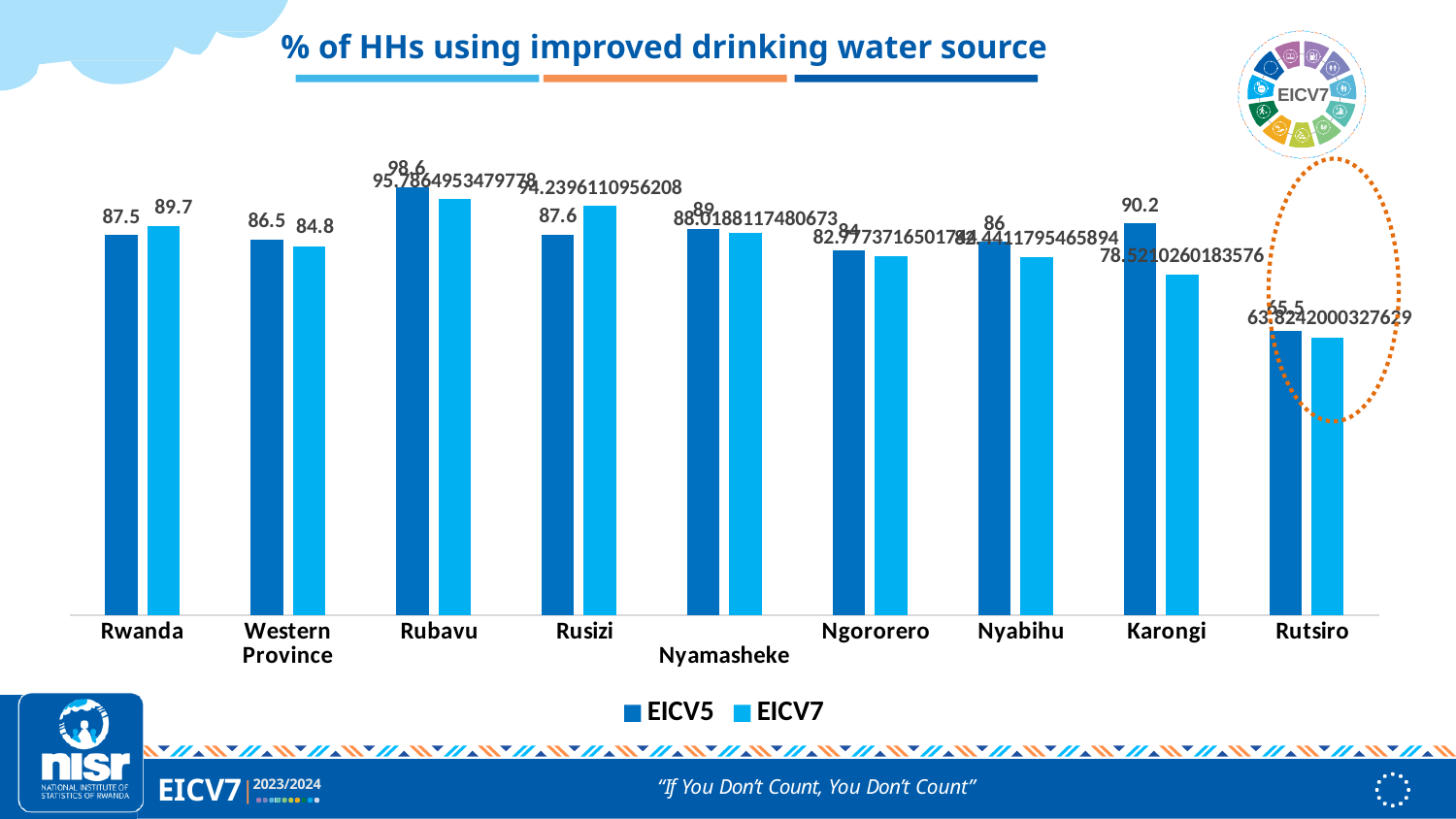
What is the EICV7 value for Western Province? 84.8 What kind of chart is shown on the slide? Bar chart What is the difference between the EICV5 and EICV7 values for Western Province? 1.7 Which category has the highest EICV5 value? Rubavu How many series does the legend list? 2 Which category has the lowest EICV7 value? Rutsiro How many categories are shown on the x axis? 9 What is the EICV5 value for Karongi? 90.2 What is the EICV5 value for Rutsiro? 65.5 For Rusizi, which is larger: the EICV5 value or the EICV7 value? EICV7 What is the EICV7 value for Rwanda? 89.7 What is the difference between the EICV7 and EICV5 values for Rwanda? 2.2